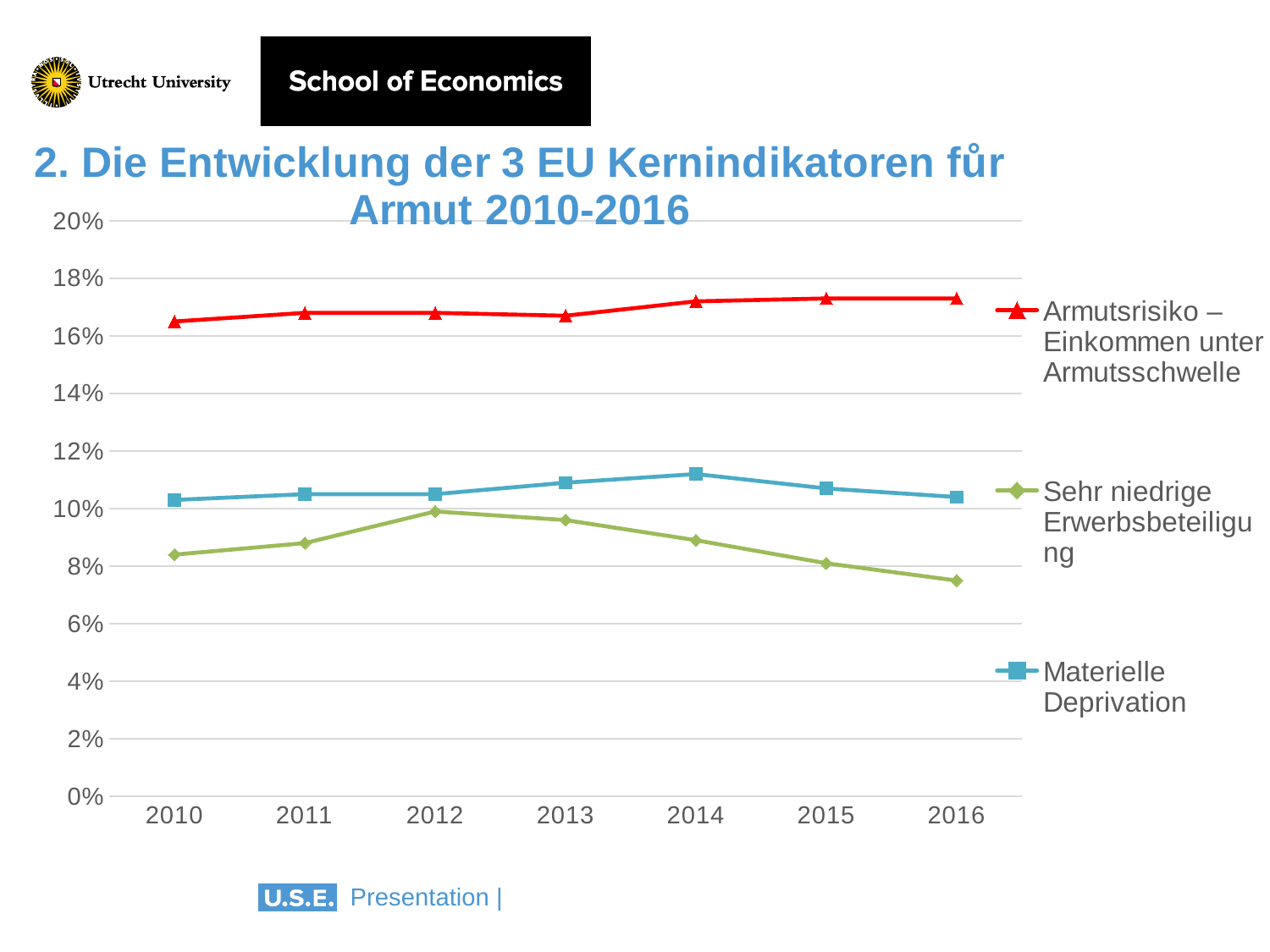
What kind of chart is shown on the slide? Line chart How many series does the legend list? 3 Is the value for Materielle Deprivation in 2014 greater or less than 10%? greater Which series is drawn with a red line and triangle markers? Armutsrisiko – Einkommen unter Armutsschwelle Does Sehr niedrige Erwerbsbeteiligung rise or fall from 2012 to 2016? Fall In which year is Sehr niedrige Erwerbsbeteiligung at its lowest? 2016 In 2010, which is higher: Materielle Deprivation or Sehr niedrige Erwerbsbeteiligung? Materielle Deprivation How many years are shown on the x axis? 7 In which year is Sehr niedrige Erwerbsbeteiligung at its highest? 2012 In which year is Materielle Deprivation at its highest? 2014 Is the value for Armutsrisiko – Einkommen unter Armutsschwelle in 2010 greater or less than 16%? greater Is the value for Sehr niedrige Erwerbsbeteiligung in 2016 greater or less than 8%? less